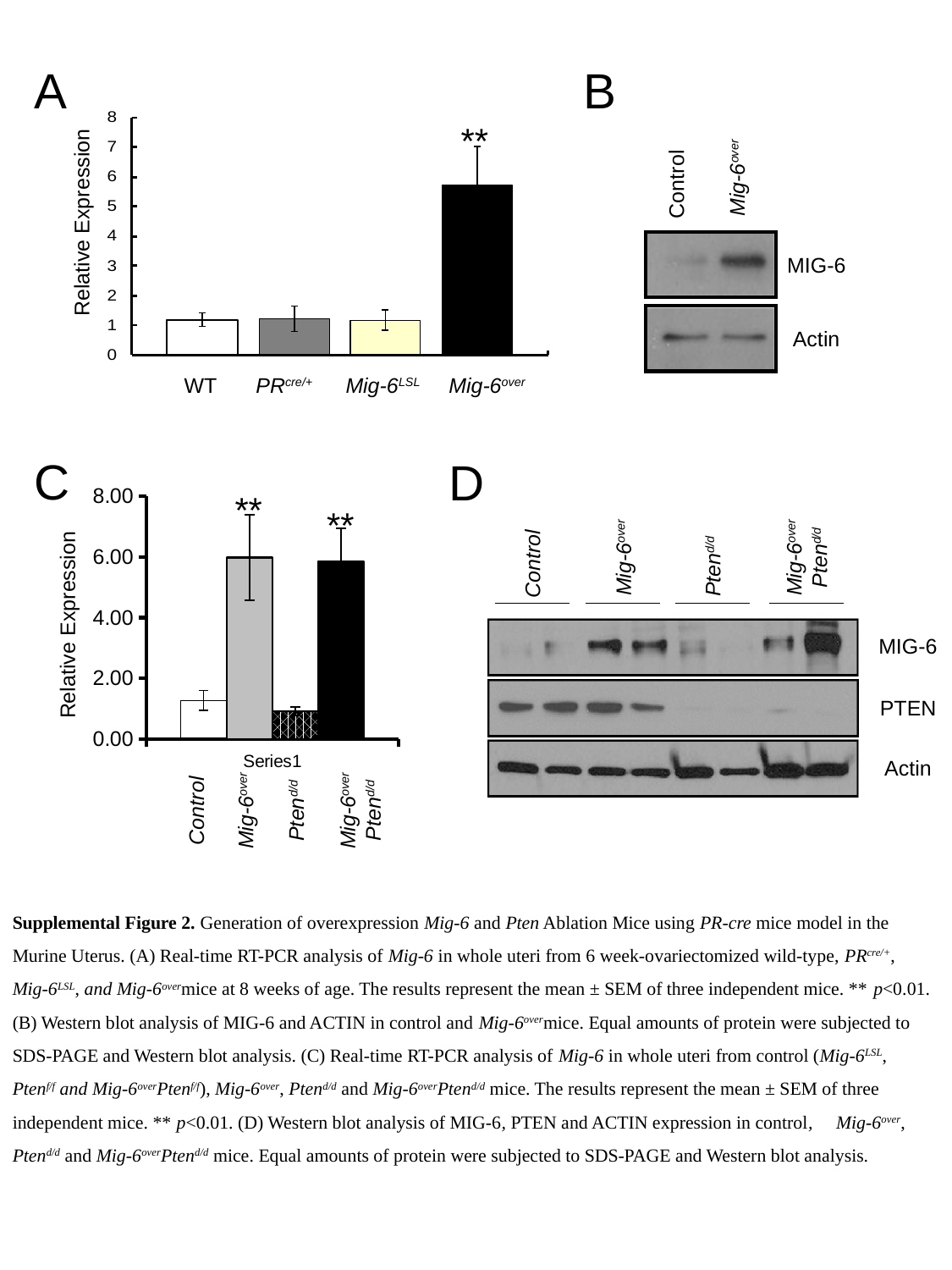
How many bars are plotted in the panel C chart? 4 In the panel A chart, is the value for Mig-6over greater or less than 4? greater What kind of chart is shown in panel A? bar chart In the panel A chart, which is larger, the value for Mig-6over or the value for PRcre/+? Mig-6over In the panel C chart, is the value for Ptend/d greater or less than 2.00? less In the panel A chart, which category has the highest relative expression? Mig-6over What is the y-axis title of the panel A chart? Relative Expression How many categories are plotted in the panel A chart? 4 In the panel A chart, is the value for WT greater or less than 2? less What is the highest tick value shown on the y axis of the panel C chart? 8.00 In the panel C chart, which is larger, the value for Control or the value for Mig-6overPtend/d? Mig-6overPtend/d